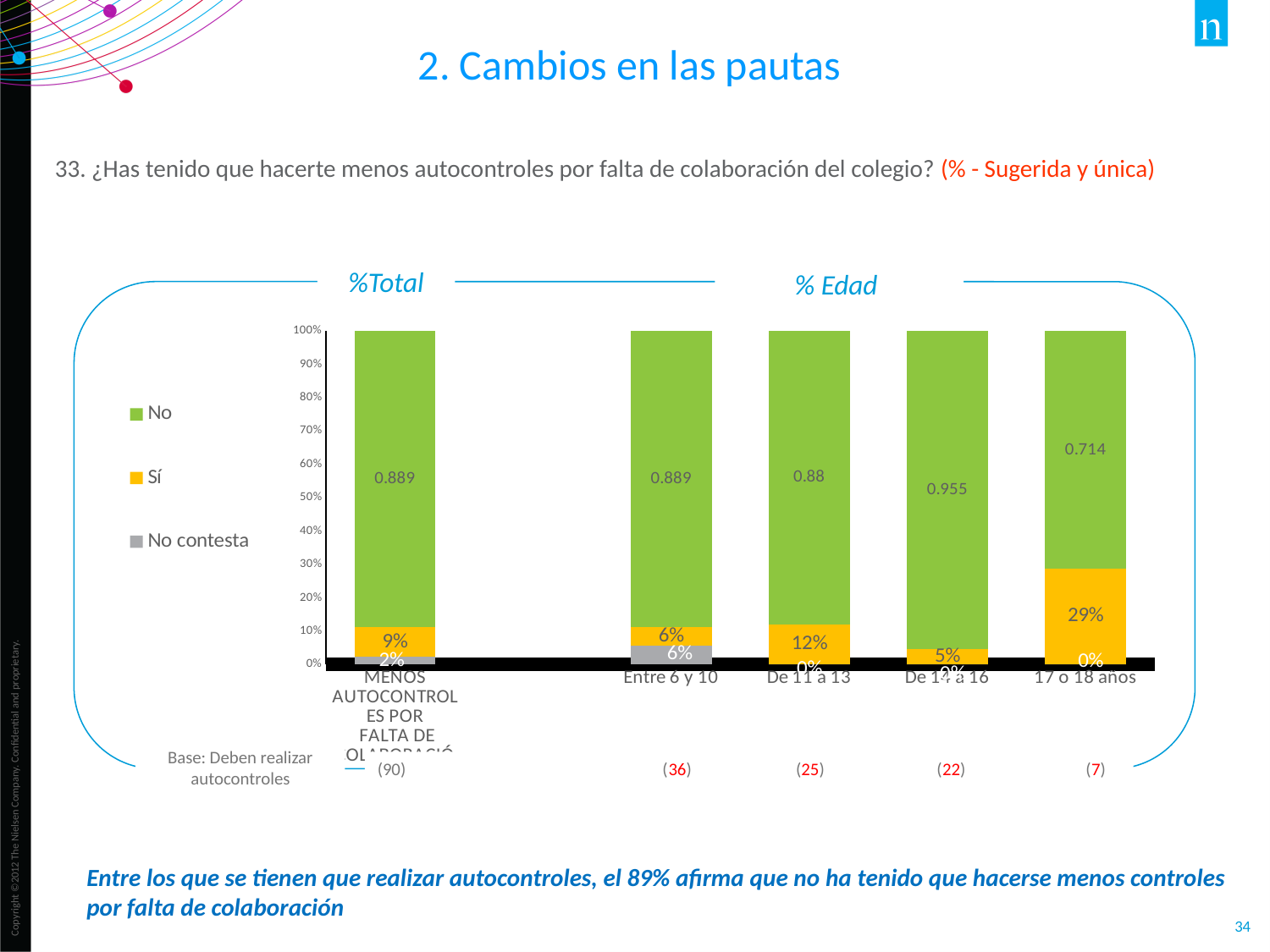
Which category has the highest value for the 'Sí' series? 17 o 18 años What are the three entries in the chart legend? No, Sí, No contesta What kind of chart is shown on the slide? Stacked bar chart What is the value of the 'Sí' series for the '17 o 18 años' category? 29% How many series does the legend list? 3 What is the value of the 'No' series for the 'De 14 a 16' category? 0.955 What is the difference between the 'Sí' values for '17 o 18 años' and 'Entre 6 y 10'? 23% How many categories (bars) are shown in the chart? 5 What is the value of the 'Sí' series for the 'De 11 a 13' category? 12% Which is larger: the 'Sí' value for 'De 11 a 13' or for 'De 14 a 16'? De 11 a 13 Which category has the lowest value for the 'No' series? 17 o 18 años What is the value of the 'No contesta' series for the 'Entre 6 y 10' category? 6%